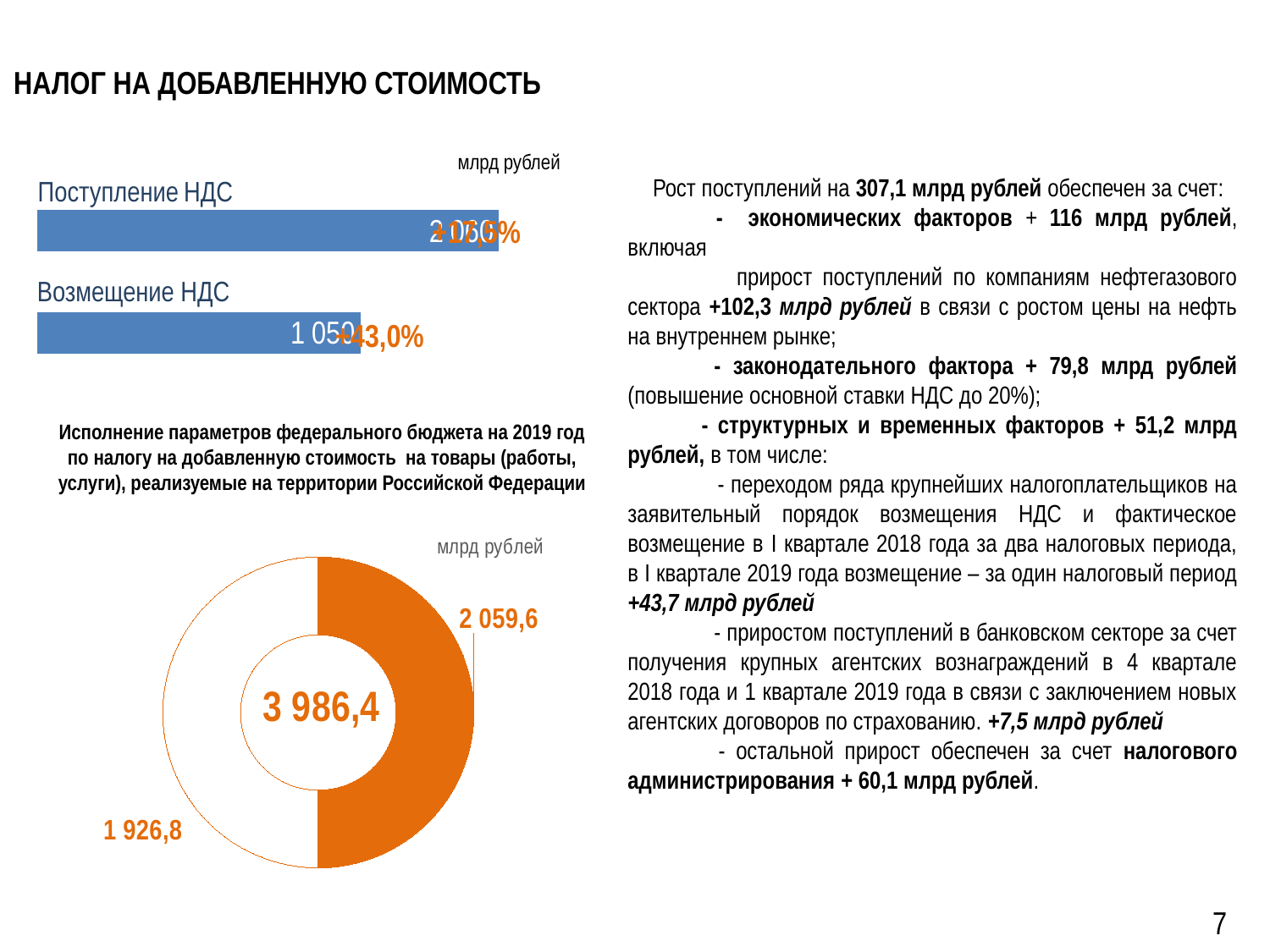
In the bar chart at the top left, how many categories are shown? 2 In the donut chart at the bottom left, what unit is indicated above the chart? млрд рублей In the donut chart at the bottom left, what value is labelled on the white segment? 1 926,8 In the donut chart at the bottom left, what is the total of the two segments? 3 986,4 In the donut chart at the bottom left, what is the difference between the orange segment (2 059,6) and the white segment (1 926,8)? 132,8 What kind of chart is shown at the bottom left of the slide? donut (pie) chart What kind of chart is shown at the top left of the slide, under the heading 'Поступление НДС' and 'Возмещение НДС'? bar chart In the donut chart at the bottom left, which segment is larger, the orange one or the white one? the orange one In the donut chart at the bottom left, what value is labelled on the orange segment? 2 059,6 In the bar chart at the top left, which bar is longer, 'Поступление НДС' or 'Возмещение НДС'? Поступление НДС In the donut chart at the bottom left, what value is shown in the centre of the ring? 3 986,4 In the donut chart at the bottom left, how many segments does the ring have? 2